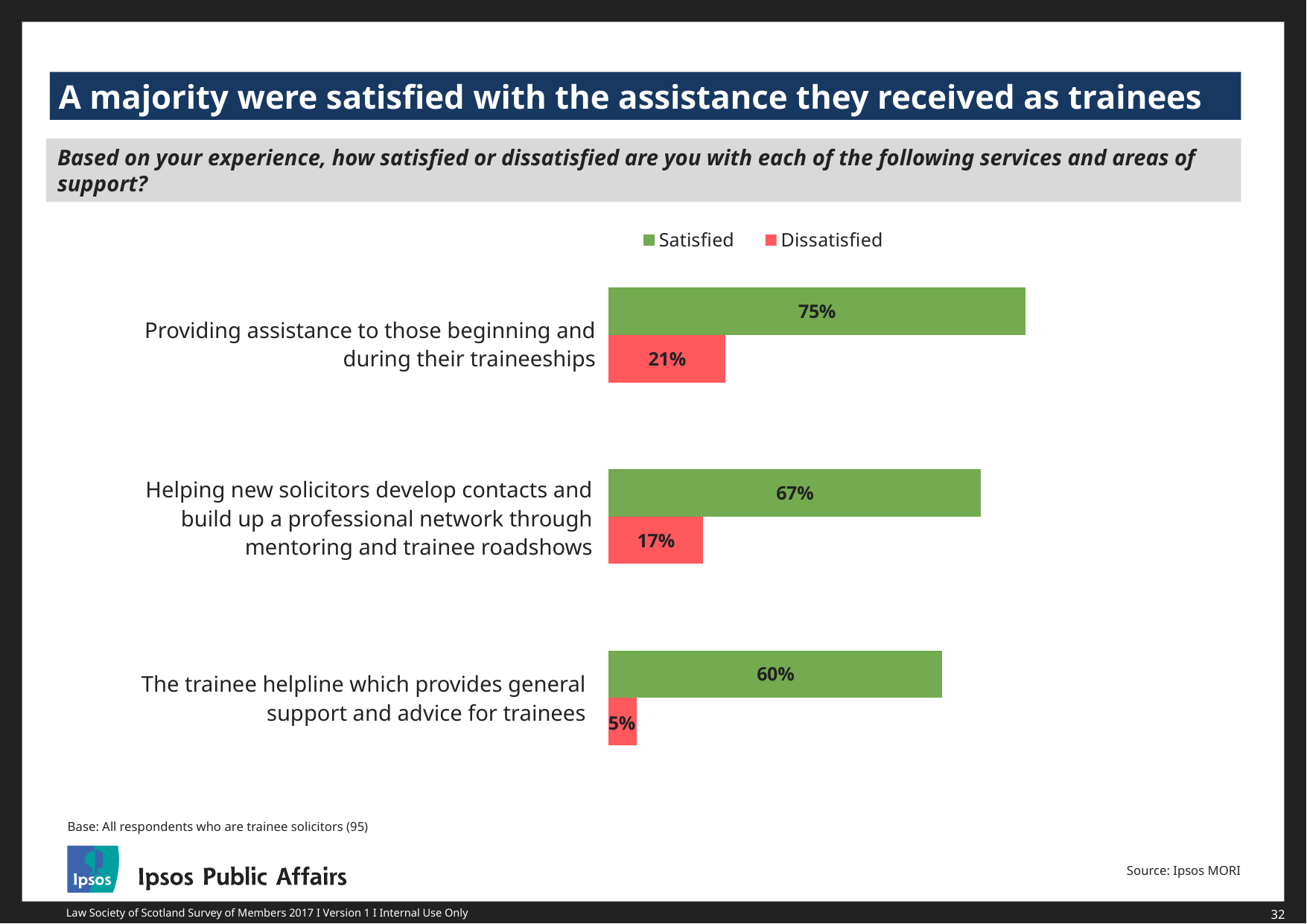
Which service has the highest satisfied percentage? Providing assistance to those beginning and during their traineeships What percentage were dissatisfied with the trainee helpline which provides general support and advice for trainees? 5% What percentage were dissatisfied with helping new solicitors develop contacts and build up a professional network? 17% What percentage were satisfied with providing assistance to those beginning and during their traineeships? 75% What is the difference between the satisfied percentages for providing assistance during traineeships and the trainee helpline? 15 percentage points What percentage were satisfied with helping new solicitors develop contacts and build up a professional network through mentoring and trainee roadshows? 67% How many series does the legend list? 2 Which is larger: the dissatisfied percentage for providing assistance during traineeships or for helping new solicitors develop contacts? Providing assistance to those beginning and during their traineeships What kind of chart is shown on the slide? Bar chart What is the difference between the satisfied and dissatisfied percentages for the trainee helpline? 55 percentage points How many services are shown in the chart? 3 Which service has the lowest dissatisfied percentage? The trainee helpline which provides general support and advice for trainees